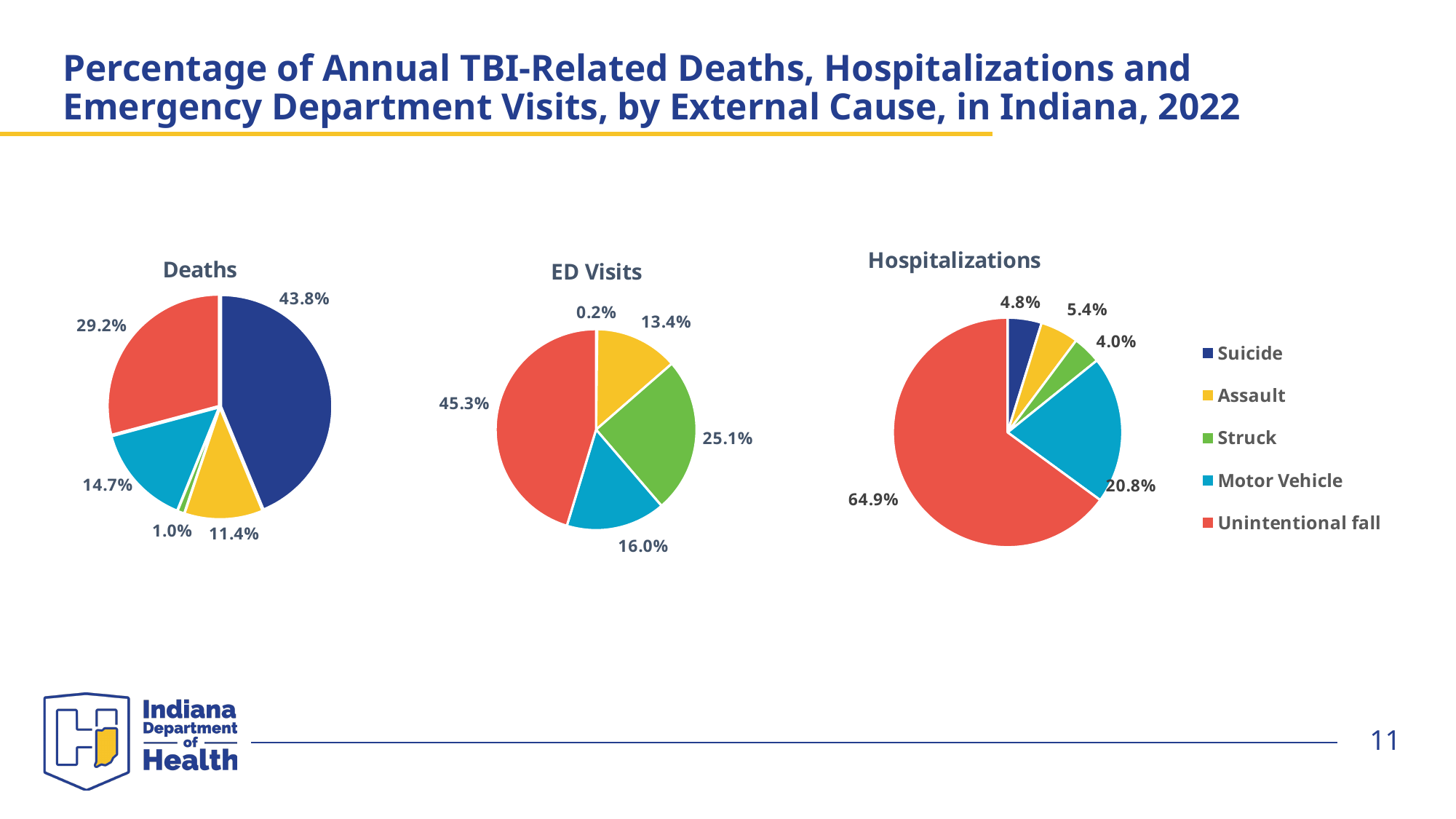
In the Deaths pie chart, which cause has the smallest share? Struck In the Hospitalizations pie chart, what percentage is attributed to Motor Vehicle? 20.8% How many slices does the Hospitalizations pie chart have? 5 How many entries does the legend list? 5 In the Hospitalizations pie chart, which cause has the largest share? Unintentional fall In the ED Visits pie chart, what percentage is attributed to Struck? 25.1% In the Deaths pie chart, what percentage is attributed to Suicide? 43.8% Which colour represents Unintentional fall in the legend? Red In the ED Visits pie chart, which is larger: the Assault share or the Motor Vehicle share? Motor Vehicle In the Deaths pie chart, what is the difference between the Suicide share and the Unintentional fall share? 14.6% What type of chart is used for Deaths, ED Visits and Hospitalizations on this slide? Pie chart In the ED Visits pie chart, which cause has the smallest share? Suicide